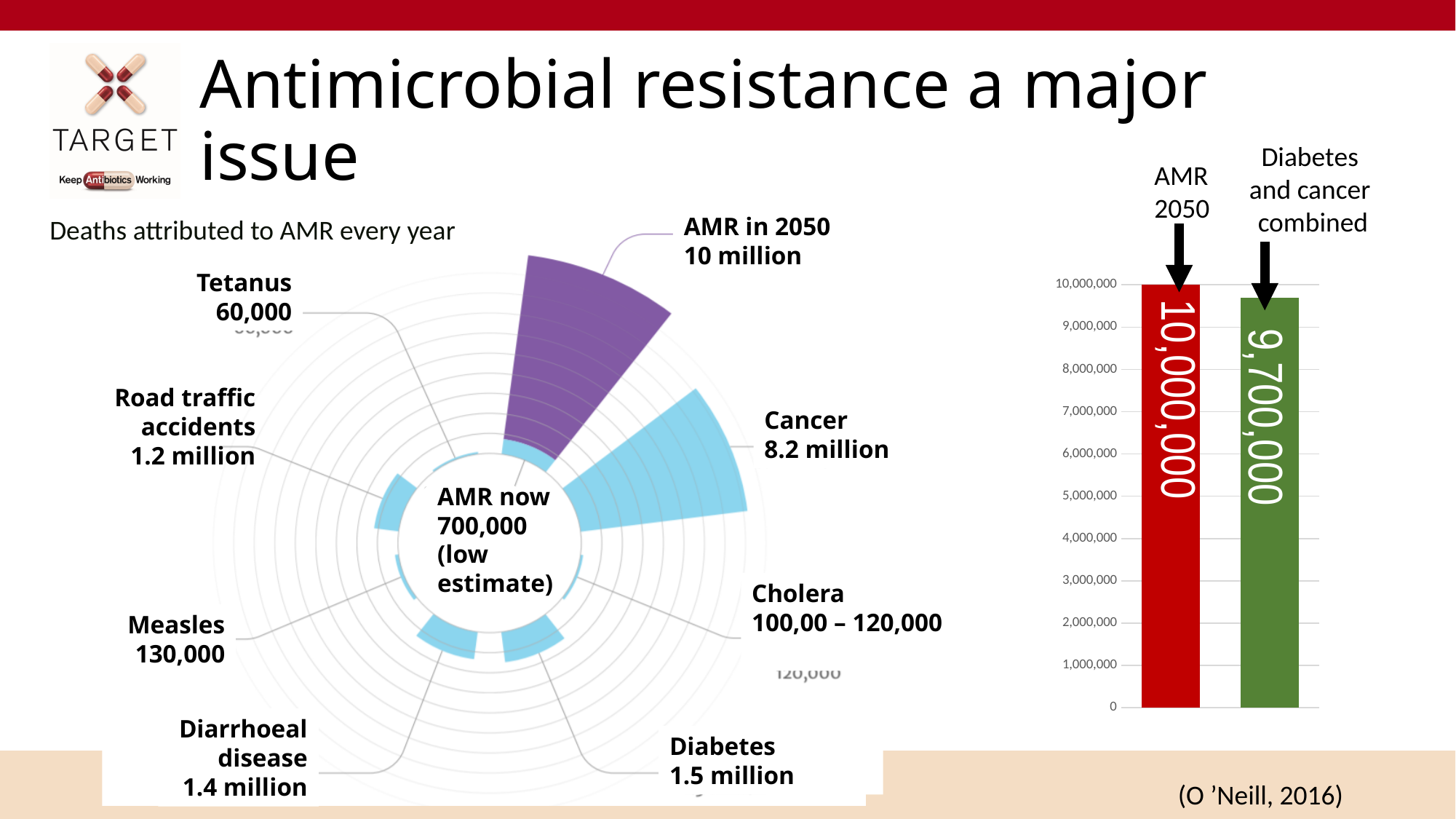
What kind of chart is the chart on the right of the slide? Bar chart On the 'Deaths attributed to AMR every year' chart, what is the difference between Measles and Tetanus deaths? 70,000 On the bar chart on the right, what is the value for AMR 2050? 10,000,000 On the 'Deaths attributed to AMR every year' chart, how many deaths are attributed to Tetanus? 60,000 On the bar chart on the right, which bar is taller: AMR 2050 or Diabetes and cancer combined? AMR 2050 On the bar chart on the right, what is the value for Diabetes and cancer combined? 9,700,000 On the 'Deaths attributed to AMR every year' chart, which category has the smallest value? Tetanus How many bars are shown on the bar chart on the right? 2 On the bar chart on the right, what is the difference between the AMR 2050 bar and the Diabetes and cancer combined bar? 300,000 On the 'Deaths attributed to AMR every year' chart, which category has the largest value? AMR in 2050 On the 'Deaths attributed to AMR every year' chart, how many deaths are attributed to Cancer? 8.2 million On the bar chart on the right, what colour is the AMR 2050 bar? Red